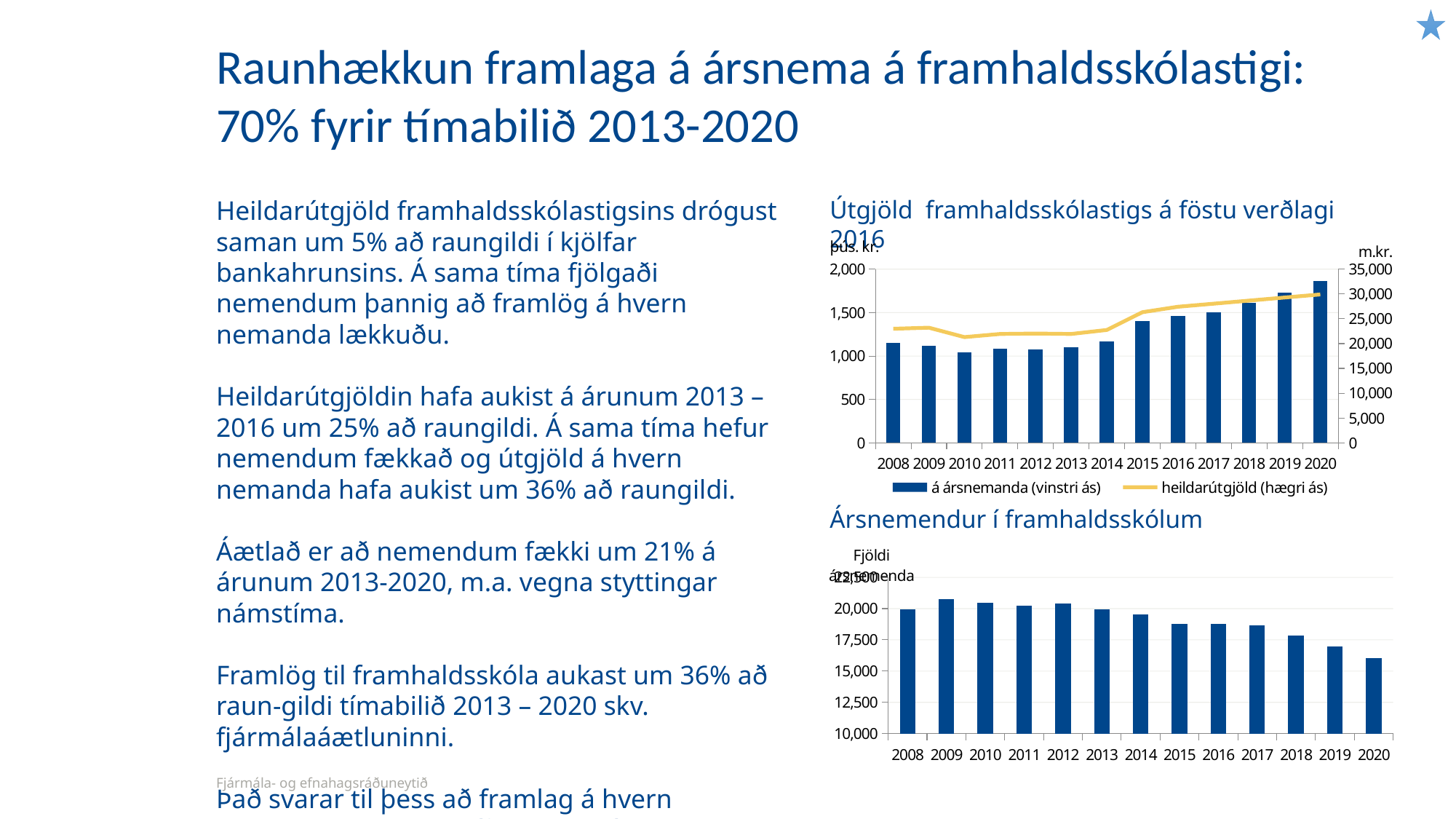
In the 'Ársnemendur í framhaldsskólum' chart, which year has the lowest value? 2020 In the 'Ársnemendur í framhaldsskólum' chart, which year has the highest value? 2009 How many series does the legend of the 'Útgjöld framhaldsskólastigs á föstu verðlagi 2016' chart list? 2 In the 'Útgjöld framhaldsskólastigs á föstu verðlagi 2016' chart, which year has the highest bar for 'á ársnemanda'? 2020 In the 'Útgjöld framhaldsskólastigs á föstu verðlagi 2016' chart, is the 'á ársnemanda' value for 2020 greater or less than 1,500? greater In the 'Ársnemendur í framhaldsskólum' chart, is the value for 2020 greater or less than 17,500? less In the 'Útgjöld framhaldsskólastigs á föstu verðlagi 2016' chart, which year has the lowest bar for 'á ársnemanda'? 2010 In the 'Útgjöld framhaldsskólastigs á föstu verðlagi 2016' chart, which series is drawn as a line? heildarútgjöld (hægri ás) How many years are shown on the x axis of the 'Ársnemendur í framhaldsskólum' chart? 13 In the 'Útgjöld framhaldsskólastigs á föstu verðlagi 2016' chart, is the 'heildarútgjöld' value for 2010 greater or less than 25,000? less What kind of chart is the 'Ársnemendur í framhaldsskólum' chart? bar chart In the 'Ársnemendur í framhaldsskólum' chart, do the values rise or fall from 2012 to 2020? fall